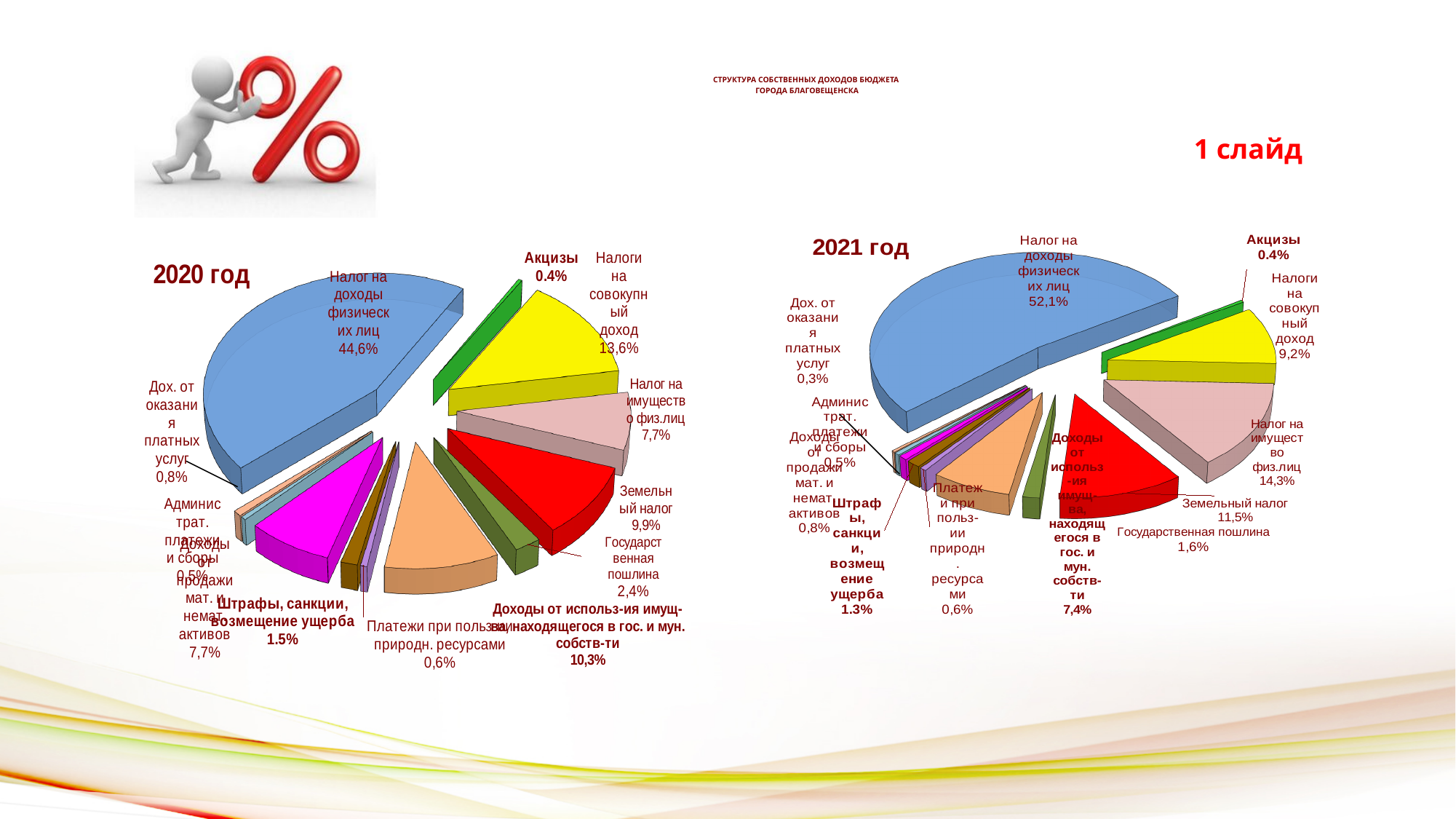
What is the difference between the share of Налог на доходы физических лиц in the 2021 год chart and in the 2020 год chart? 7,5% On the 2021 год pie chart, what share is shown for Налог на доходы физических лиц? 52,1% On the 2021 год pie chart, which is larger: Земельный налог or Налоги на совокупный доход? Земельный налог How many categories are shown on the 2021 год pie chart? 12 On the 2020 год pie chart, what share is shown for Налог на доходы физических лиц? 44,6% On the 2021 год pie chart, which category has the smallest share? Дох. от оказания платных услуг On the 2020 год pie chart, which category has the largest share? Налог на доходы физических лиц On the 2020 год pie chart, what share is shown for Земельный налог? 9,9% On the 2021 год pie chart, what share is shown for Налог на имущество физ.лиц? 14,3% On the 2020 год pie chart, which is larger: Налоги на совокупный доход or Налог на имущество физ.лиц? Налоги на совокупный доход What type of chart is used for the 2020 год data? Pie chart On the 2021 год pie chart, what share is shown for Государственная пошлина? 1,6%